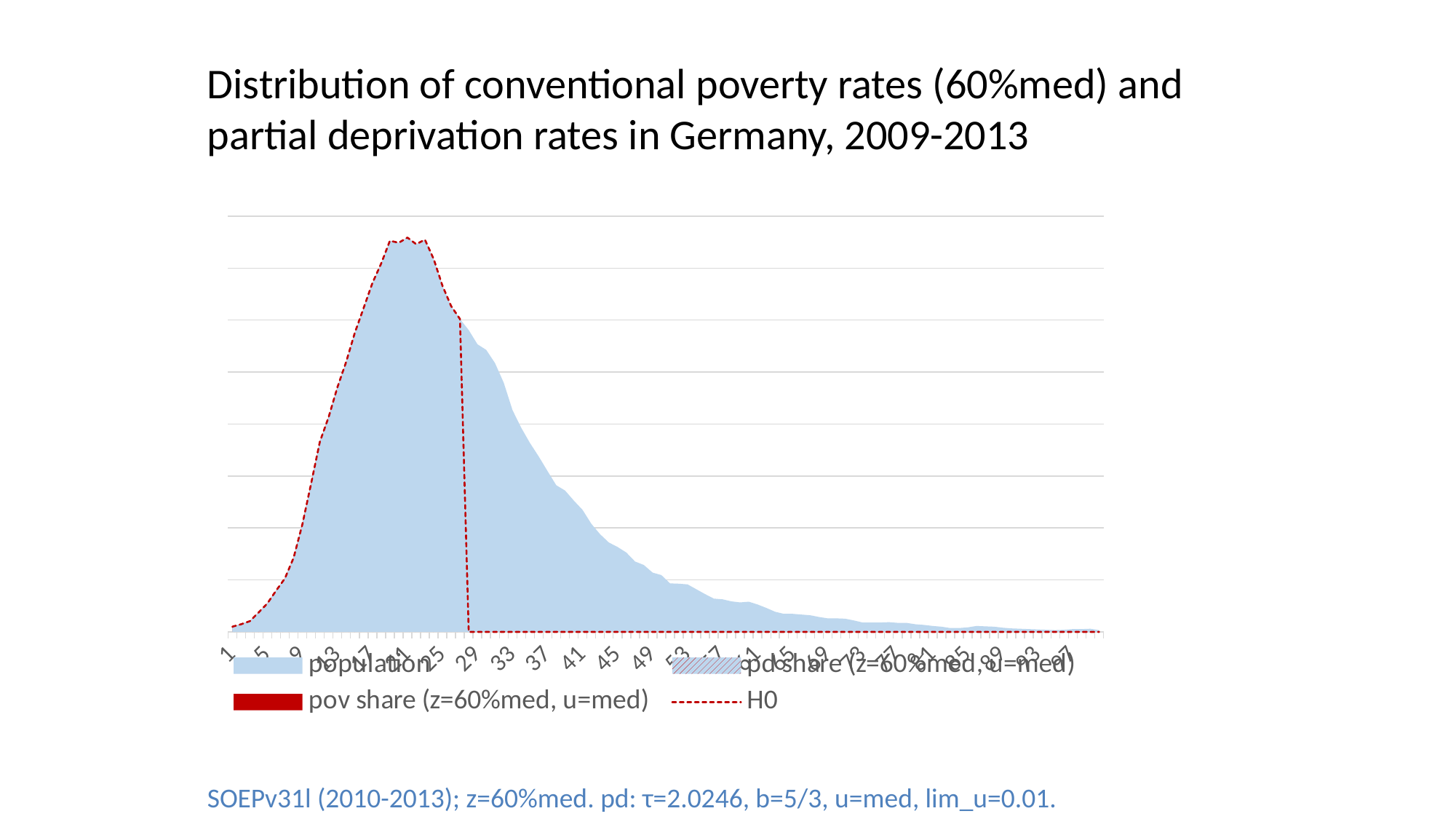
What kind of chart is shown on the slide? combination area and line chart Is the population value at x=33 larger or smaller than at x=41? larger Is the population value at x=45 larger or smaller than at x=37? smaller What is the title of the chart? Distribution of conventional poverty rates (60%med) and partial deprivation rates in Germany, 2009-2013 Does the population series rise or fall along the x axis after reaching its peak? fall How many series does the legend list? 4 Which legend entry is drawn as a red dashed line? H0 Is the population value at x=29 larger or smaller than at x=49? larger